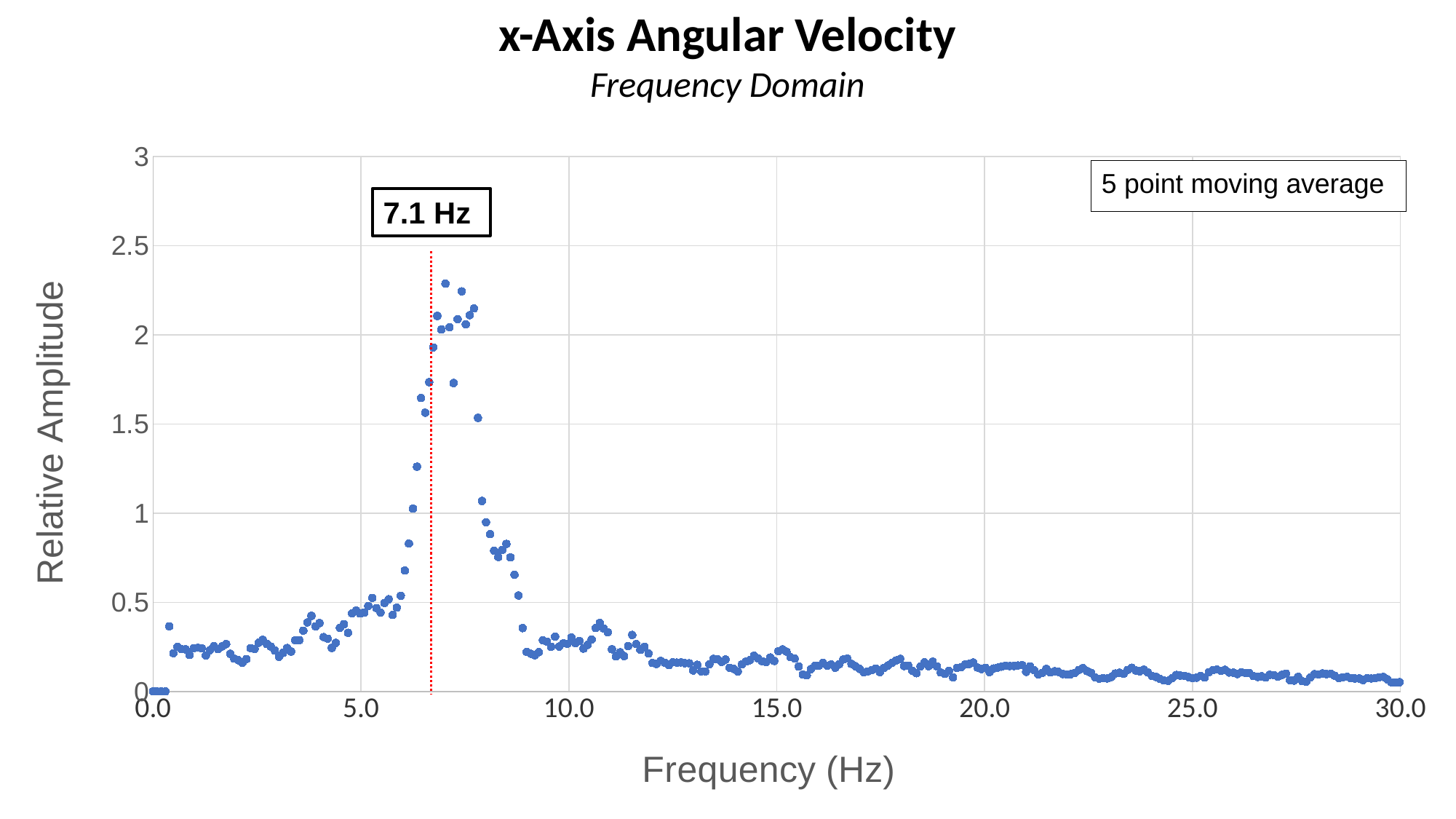
What kind of chart is shown on the slide? Scatter plot What is the maximum value shown on the y axis? 3 What is the maximum frequency shown on the x axis? 30.0 What frequency is labelled at the annotated peak of the chart? 7.1 Hz Between 10.0 Hz and 30.0 Hz, do the relative amplitude values generally rise or fall as frequency increases? fall Is the relative amplitude at 20.0 Hz greater or less than 0.5? less What is the title of the chart? x-Axis Angular Velocity What is the label of the x axis? Frequency (Hz) What is the label of the y axis? Relative Amplitude Is the highest relative amplitude on the chart greater or less than 2? greater Is the relative amplitude at 25.0 Hz greater or less than 1? less What does the text box in the upper right of the chart say? 5 point moving average